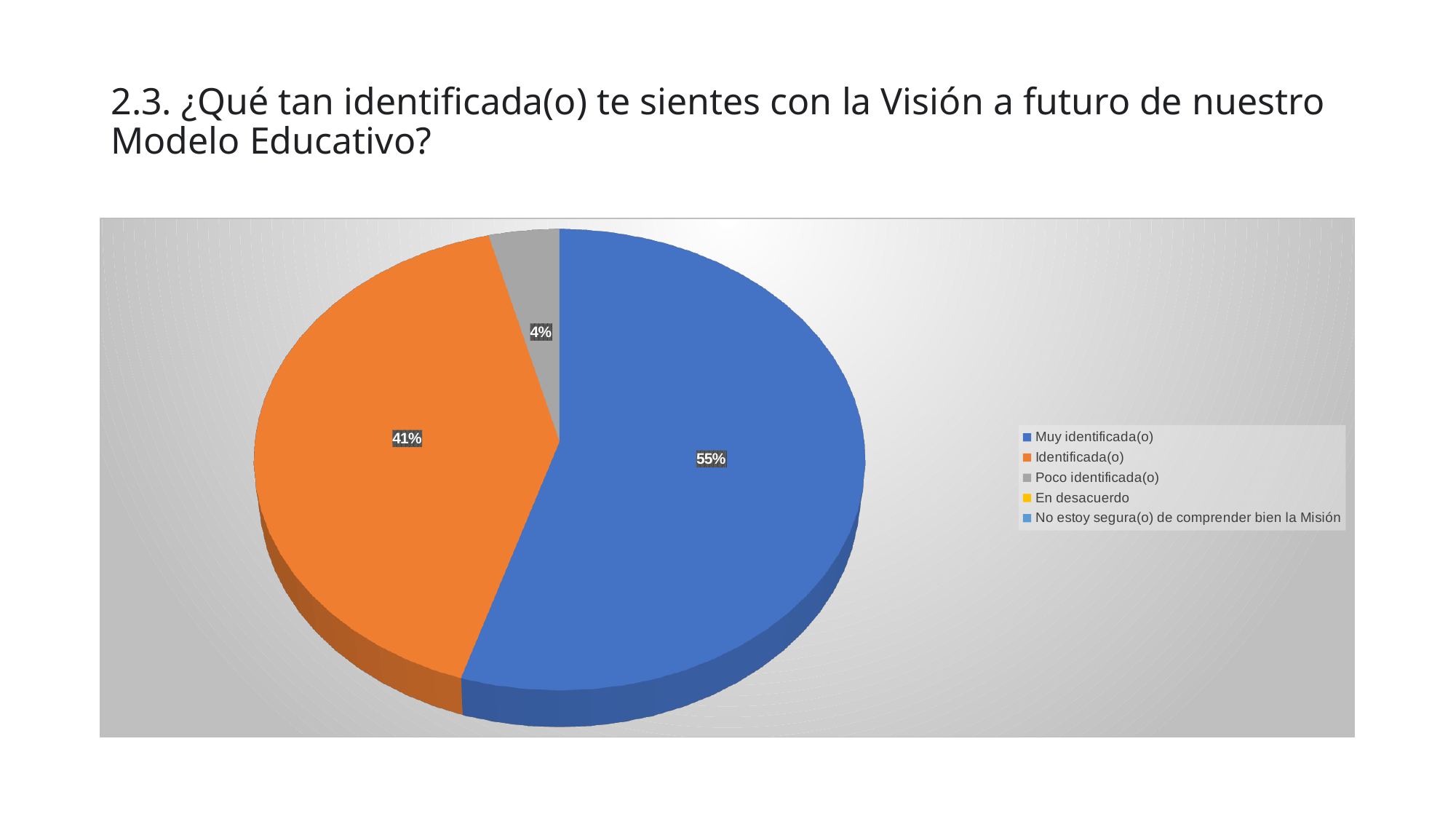
What colour is the "Identificada(o)" slice? Orange What percentage of respondents answered "Identificada(o)"? 41% Which response category has the smallest visible slice of the pie? Poco identificada(o) What percentage of respondents answered "Poco identificada(o)"? 4% What is the difference in percentage points between "Muy identificada(o)" and "Identificada(o)"? 14 How many entries does the legend list? 5 What kind of chart is shown on the slide? Pie chart Which is larger, the share for "Identificada(o)" or the share for "Poco identificada(o)"? Identificada(o) Which response category has the largest slice of the pie? Muy identificada(o) What percentage of respondents answered "Muy identificada(o)"? 55% How many slices with data labels are visible in the pie? 3 What share of the pie does the "Muy identificada(o)" slice represent? 55%